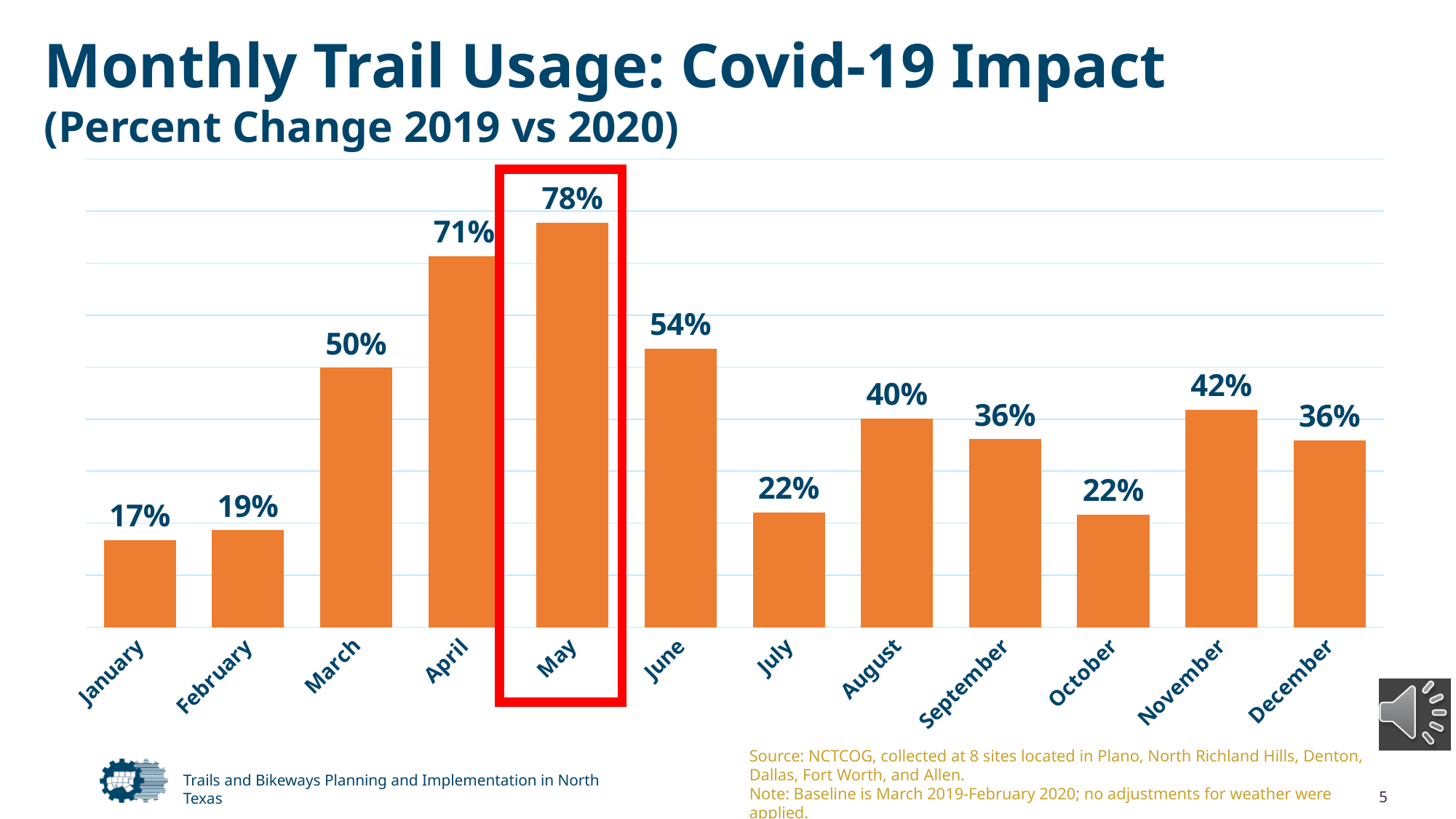
Which month has a larger percent change, March or December? March Which month has the lowest percent change in trail usage? January Which month has the highest percent change in trail usage? May What is the difference between the percent change for May and the percent change for April? 7% Which month has a larger percent change, August or September? August What is the percent change in trail usage for May? 78% What is the difference between the percent change for June and the percent change for July? 32% Which month is highlighted with a red box on the chart? May What is the percent change in trail usage for January? 17% What type of chart is shown on the slide? Bar chart What is the percent change in trail usage for November? 42% How many months are shown on the chart? 12